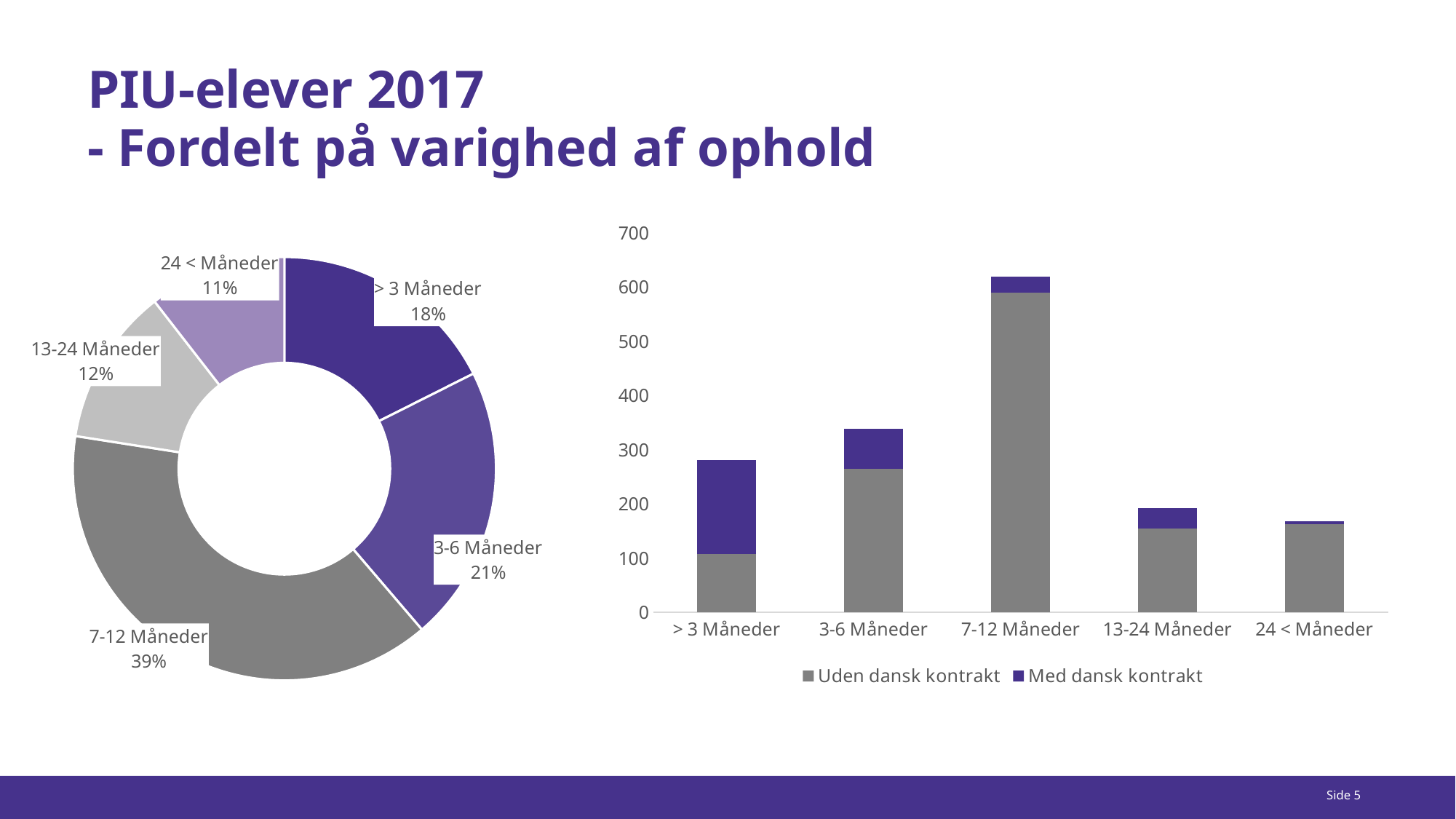
On the doughnut chart on the left, what share is shown for 7-12 Måneder? 39% On the doughnut chart on the left, which category has the smallest share? 24 < Måneder How many categories does the doughnut chart on the left show? 5 On the bar chart on the right, is the total for 7-12 Måneder greater or less than 600? greater What kind of chart is on the right side of the slide? Stacked bar chart On the doughnut chart on the left, which is larger: the share for 13-24 Måneder or the share for > 3 Måneder? > 3 Måneder How many series does the legend of the bar chart on the right list? 2 On the doughnut chart on the left, what share is shown for 24 < Måneder? 11% On the doughnut chart on the left, what share is shown for 3-6 Måneder? 21% On the doughnut chart on the left, what is the difference in percentage points between 7-12 Måneder and > 3 Måneder? 21 percentage points On the doughnut chart on the left, which category has the largest share? 7-12 Måneder